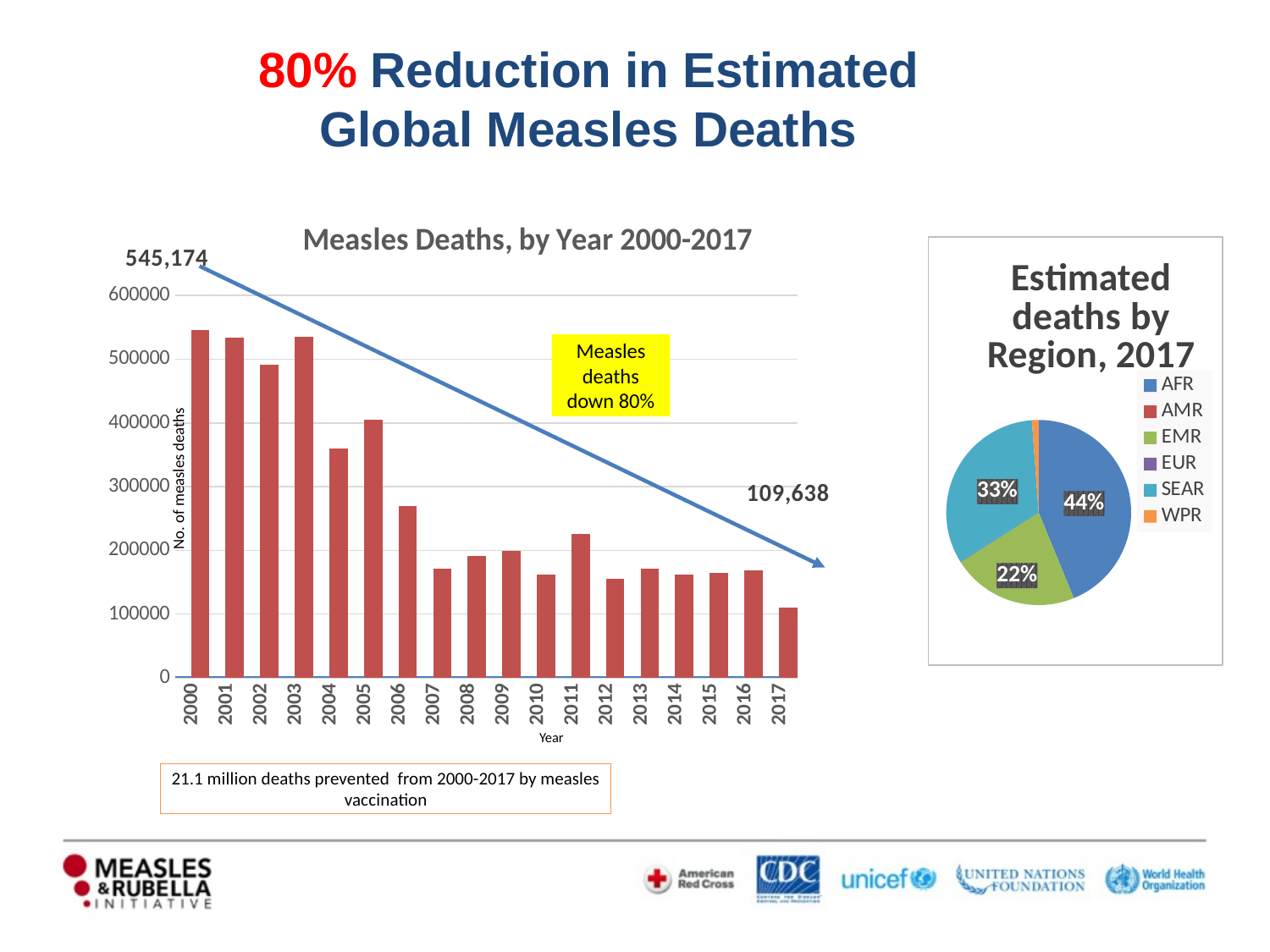
In the 'Measles Deaths, by Year 2000-2017' chart, is the value for 2004 greater or less than 400000? less What kind of chart is 'Measles Deaths, by Year 2000-2017'? Bar chart In the 'Measles Deaths, by Year 2000-2017' chart, which year has the highest number of measles deaths? 2000 In the 'Measles Deaths, by Year 2000-2017' chart, what is the number of measles deaths for 2000? 545,174 In the 'Estimated deaths by Region, 2017' pie chart, which region has the largest share? AFR In the 'Estimated deaths by Region, 2017' pie chart, what share of deaths is attributed to AFR? 44% How many regions does the legend of the 'Estimated deaths by Region, 2017' pie chart list? 6 How many years (bars) are shown in the 'Measles Deaths, by Year 2000-2017' chart? 18 In the 'Measles Deaths, by Year 2000-2017' chart, what is the number of measles deaths for 2017? 109,638 In the 'Measles Deaths, by Year 2000-2017' chart, which year has the lowest number of measles deaths? 2017 In the 'Measles Deaths, by Year 2000-2017' chart, do measles deaths generally rise or fall from 2000 to 2017? Fall In the 'Measles Deaths, by Year 2000-2017' chart, what is the difference between the 2000 value and the 2017 value? 435,536